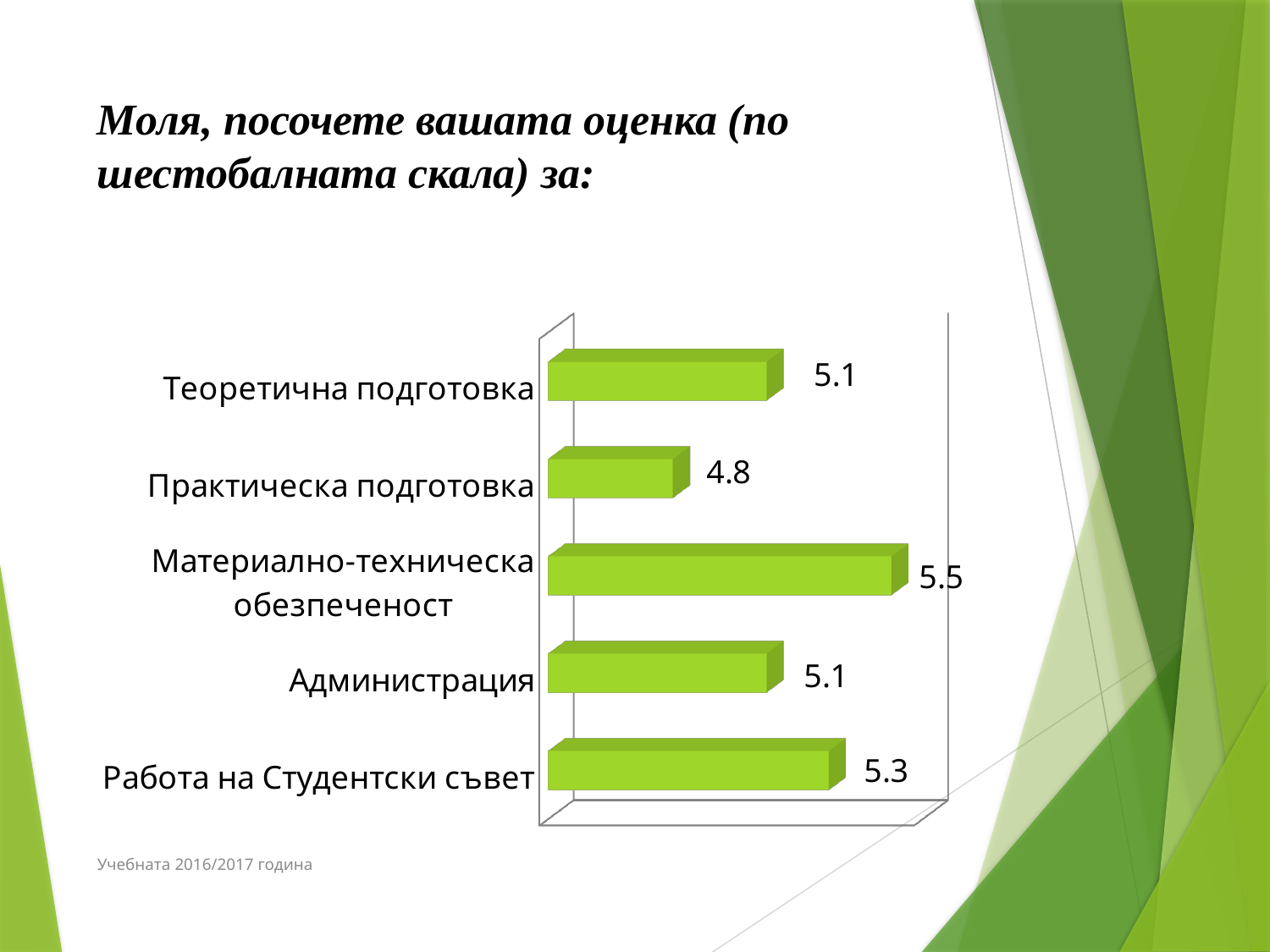
What is the value for Теоретична подготовка? 5.1 Which is larger, the value for Работа на Студентски съвет or the value for Теоретична подготовка? Работа на Студентски съвет What is the value for Работа на Студентски съвет? 5.3 How many categories are shown in the chart? 5 What is the value for Практическа подготовка? 4.8 What is the value for Материално-техническа обезпеченост? 5.5 What is the difference between the values for Материално-техническа обезпеченост and Практическа подготовка? 0.7 What is the difference between the values for Работа на Студентски съвет and Администрация? 0.2 Which category has the highest value? Материално-техническа обезпеченост What kind of chart is shown on the slide? Bar chart What colour are the bars in the chart? Green Which category has the lowest value? Практическа подготовка